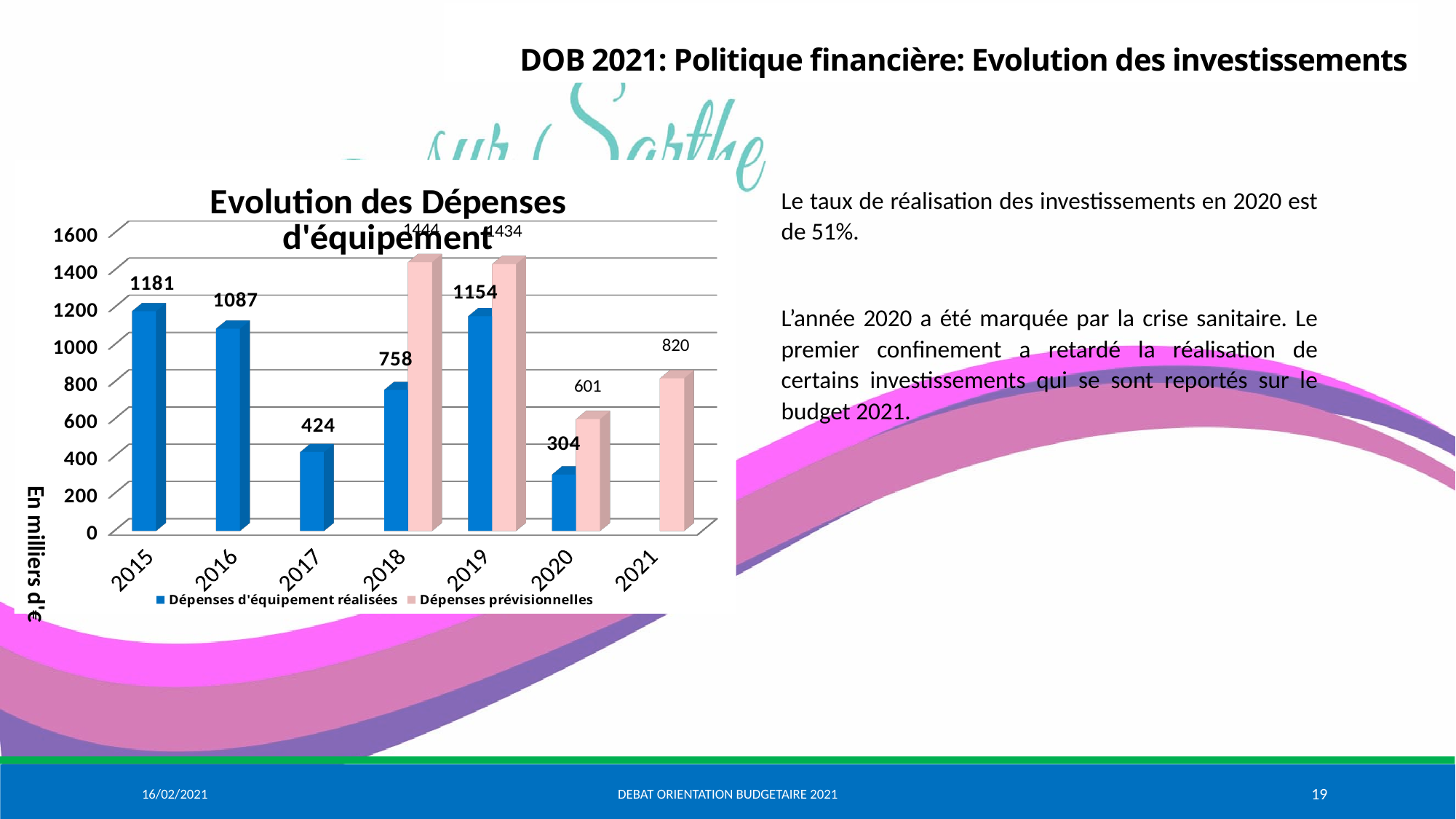
How many series does the chart legend list? 2 What kind of chart is shown on the slide? Bar chart Which is larger in 2019: Dépenses d'équipement réalisées or Dépenses prévisionnelles? Dépenses prévisionnelles How many years are shown on the x axis of the chart? 7 What is the difference between Dépenses prévisionnelles and Dépenses d'équipement réalisées in 2020? 297 Which year has the highest value for Dépenses d'équipement réalisées? 2015 What is the title of the chart? Evolution des Dépenses d'équipement What is the value of Dépenses d'équipement réalisées for 2020? 304 What is the value of Dépenses d'équipement réalisées for 2015? 1181 What is the value of Dépenses prévisionnelles for 2018? 1444 Which year has the lowest value for Dépenses d'équipement réalisées? 2020 What is the value of Dépenses prévisionnelles for 2021? 820